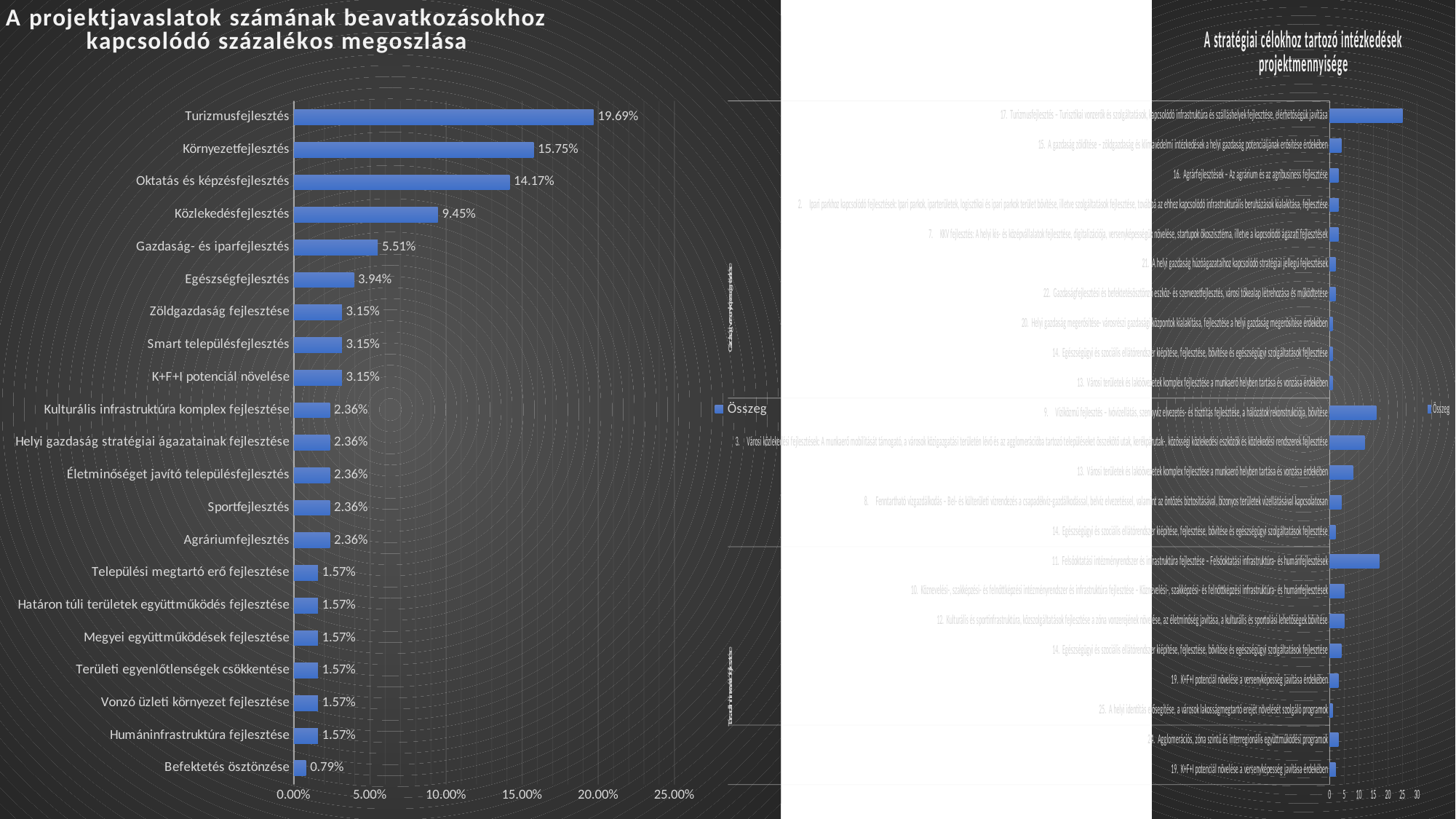
In the chart 'A projektjavaslatok számának beavatkozásokhoz kapcsolódó százalékos megoszlása', what is the value for Turizmusfejlesztés? 19.69% In the chart 'A projektjavaslatok számának beavatkozásokhoz kapcsolódó százalékos megoszlása', which category has the lowest value? Befektetés ösztönzése What kind of chart is 'A projektjavaslatok számának beavatkozásokhoz kapcsolódó százalékos megoszlása'? Bar chart In the chart 'A stratégiai célokhoz tartozó intézkedések projektmennyisége' on the right, is the value of the topmost bar greater or less than 20? greater In the chart 'A projektjavaslatok számának beavatkozásokhoz kapcsolódó százalékos megoszlása', what is the value for Egészségfejlesztés? 3.94% In the chart 'A projektjavaslatok számának beavatkozásokhoz kapcsolódó százalékos megoszlása', which category has the highest value? Turizmusfejlesztés In the chart 'A projektjavaslatok számának beavatkozásokhoz kapcsolódó százalékos megoszlása', what series name does the legend show? Összeg In the chart 'A projektjavaslatok számának beavatkozásokhoz kapcsolódó százalékos megoszlása', which is larger: Gazdaság- és iparfejlesztés or Egészségfejlesztés? Gazdaság- és iparfejlesztés In the chart 'A projektjavaslatok számának beavatkozásokhoz kapcsolódó százalékos megoszlása', how many categories are shown? 21 In the chart 'A projektjavaslatok számának beavatkozásokhoz kapcsolódó százalékos megoszlása', what is the value for Közlekedésfejlesztés? 9.45% In the chart 'A projektjavaslatok számának beavatkozásokhoz kapcsolódó százalékos megoszlása', what is the value for Sportfejlesztés? 2.36% In the chart 'A projektjavaslatok számának beavatkozásokhoz kapcsolódó százalékos megoszlása', what is the difference between Környezetfejlesztés and Oktatás és képzésfejlesztés? 1.58%